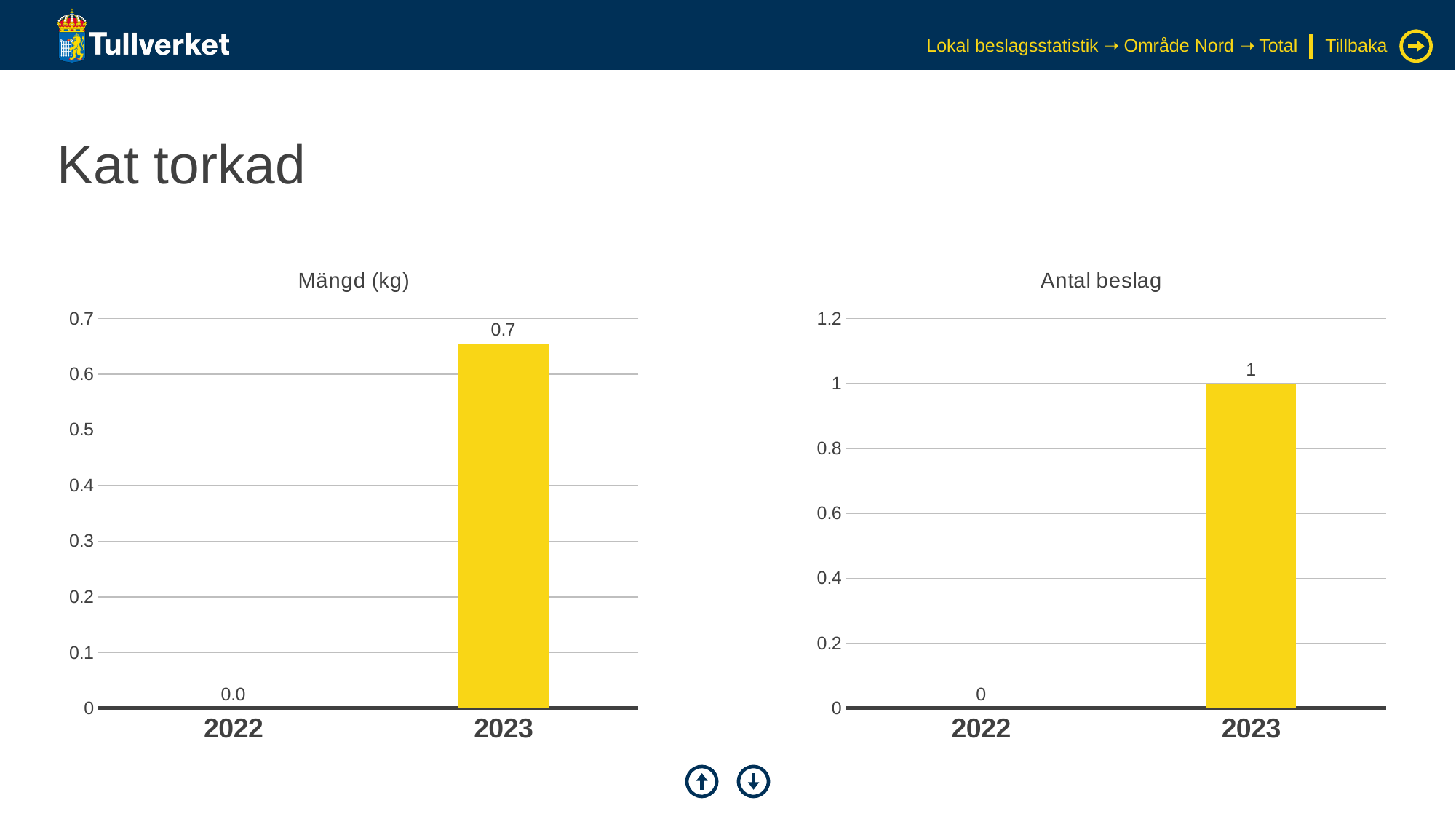
In the 'Mängd (kg)' chart, what is the value for 2022? 0.0 In the 'Antal beslag' chart, what is the value for 2023? 1 What kind of chart is the 'Antal beslag' chart? Bar chart In the 'Mängd (kg)' chart, what is the value for 2023? 0.7 In the 'Antal beslag' chart, what is the difference between the 2023 and 2022 values? 1 In the 'Mängd (kg)' chart, what is the difference between the 2023 and 2022 values? 0.7 In the 'Antal beslag' chart, which year has the lowest value? 2022 How many years are shown on the x axis of the 'Mängd (kg)' chart? 2 In the 'Antal beslag' chart, what is the value for 2022? 0 In the 'Mängd (kg)' chart, which year has the highest value? 2023 In the 'Mängd (kg)' chart, do the values rise or fall from 2022 to 2023? Rise In the 'Antal beslag' chart, which is larger, the value for 2022 or 2023? 2023